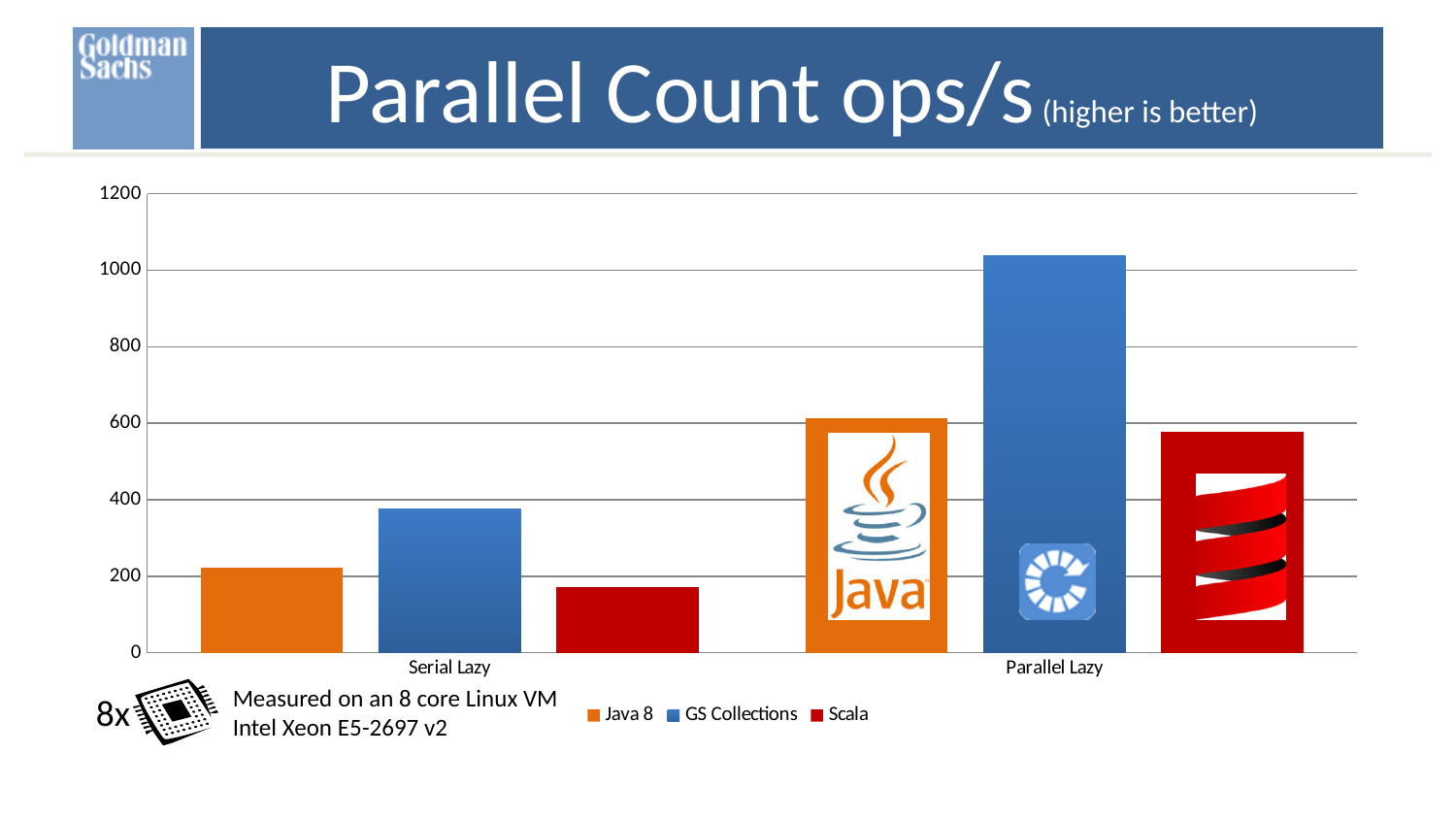
Is the value for Scala in the Parallel Lazy category greater or less than 400? greater How many categories are shown on the x axis? 2 Which series has the lowest value in the Serial Lazy category? Scala Which is larger: Java 8 in Serial Lazy or Java 8 in Parallel Lazy? Java 8 in Parallel Lazy What is the title of the chart? Parallel Count ops/s (higher is better) What kind of chart is shown on the slide? bar chart Is the value for GS Collections in the Parallel Lazy category greater or less than 1000? greater Do the values for GS Collections rise or fall from Serial Lazy to Parallel Lazy? rise Is the value for Java 8 in the Serial Lazy category greater or less than 400? less Which series has the highest value in the Parallel Lazy category? GS Collections How many series does the legend list? 3 Which is larger: GS Collections in Serial Lazy or Scala in Serial Lazy? GS Collections in Serial Lazy